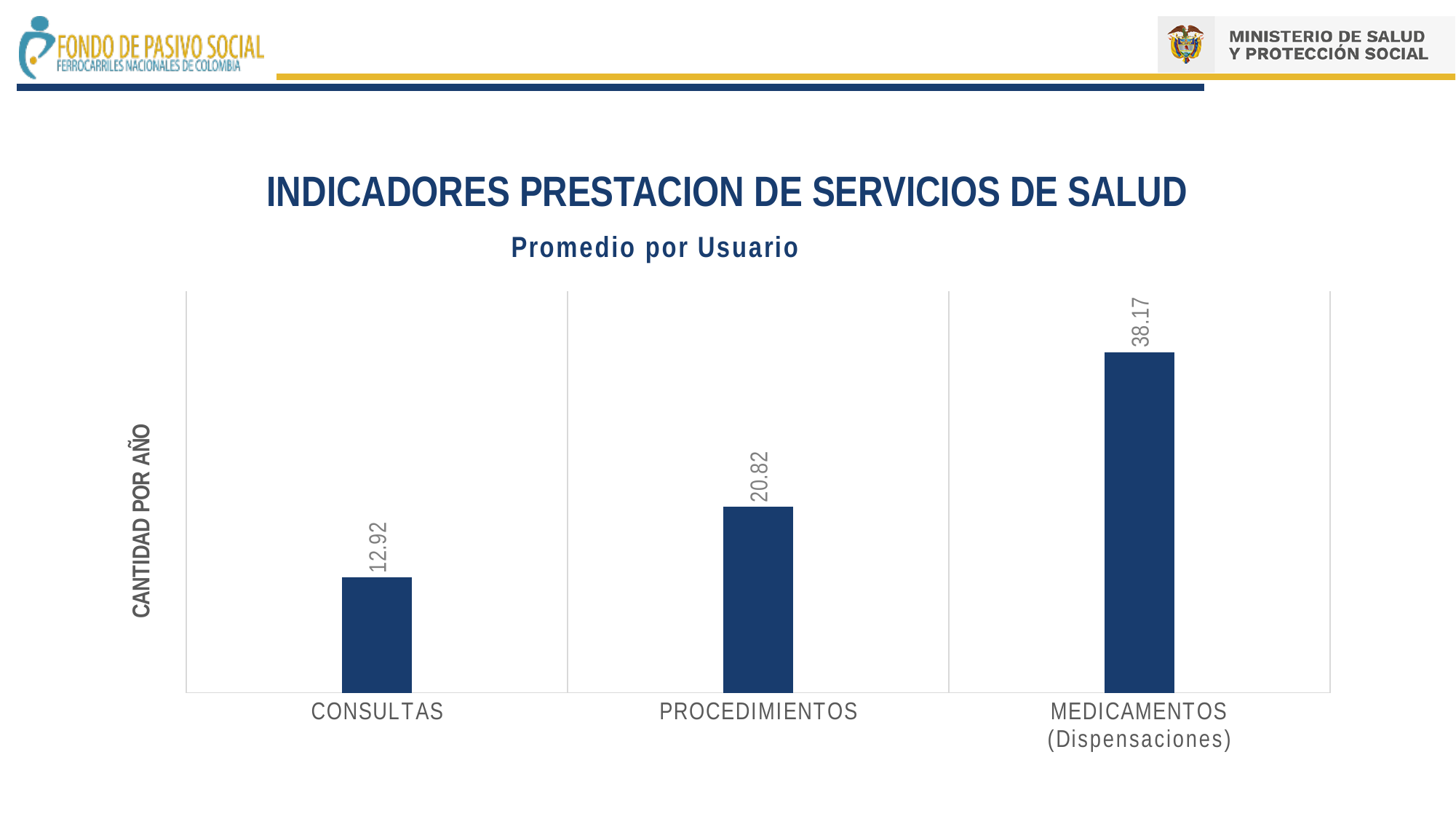
Do the values rise or fall from left to right across the categories? Rise Which category has the highest value? MEDICAMENTOS (Dispensaciones) What is the value for CONSULTAS? 12.92 Which is larger, the value for PROCEDIMIENTOS or the value for CONSULTAS? PROCEDIMIENTOS Which category has the lowest value? CONSULTAS What kind of chart is shown on the slide? Bar chart What is the difference between the values for MEDICAMENTOS (Dispensaciones) and CONSULTAS? 25.25 What is the value for PROCEDIMIENTOS? 20.82 What is the difference between the values for PROCEDIMIENTOS and CONSULTAS? 7.90 What is the value for MEDICAMENTOS (Dispensaciones)? 38.17 What is the title of the chart? Promedio por Usuario How many categories are shown in the chart? 3